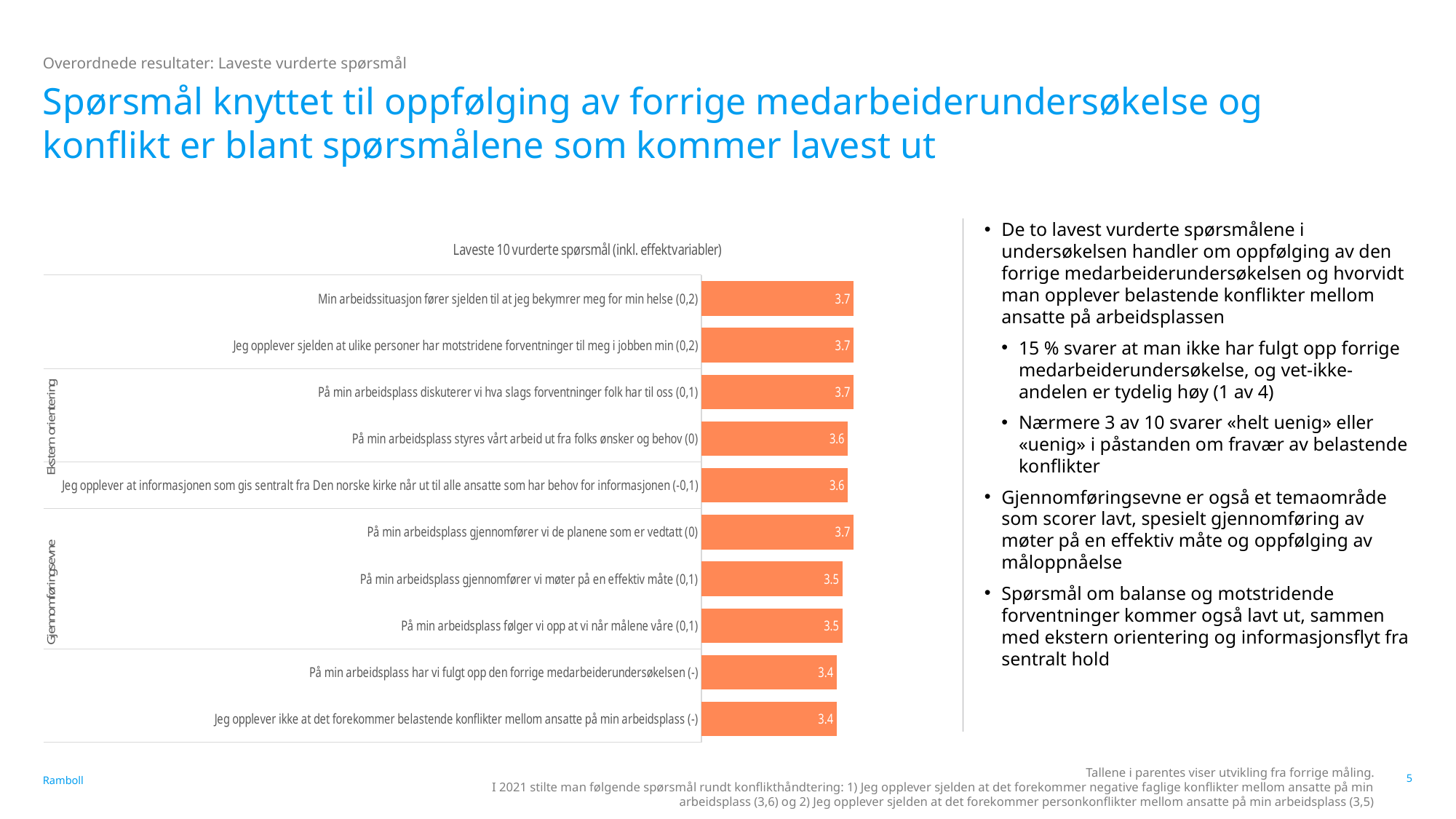
What is the title of the chart? Laveste 10 vurderte spørsmål (inkl. effektvariabler) What is the value for "På min arbeidsplass gjennomfører vi møter på en effektiv måte (0,1)"? 3.5 What is the value for "På min arbeidsplass styres vårt arbeid ut fra folks ønsker og behov (0)"? 3.6 Which has a higher value: "På min arbeidsplass diskuterer vi hva slags forventninger folk har til oss (0,1)" or "På min arbeidsplass har vi fulgt opp den forrige medarbeiderundersøkelsen (-)"? På min arbeidsplass diskuterer vi hva slags forventninger folk har til oss (0,1) How many bars (questions) are shown in the chart? 10 What is the value for "På min arbeidsplass har vi fulgt opp den forrige medarbeiderundersøkelsen (-)"? 3.4 What is the lowest value shown in the chart? 3.4 What are the two group labels shown along the left side of the chart? Ekstern orientering and Gjennomføringsevne What is the value for "Jeg opplever ikke at det forekommer belastende konflikter mellom ansatte på min arbeidsplass (-)"? 3.4 What is the difference between the value for "På min arbeidsplass gjennomfører vi de planene som er vedtatt (0)" and the value for "På min arbeidsplass følger vi opp at vi når målene våre (0,1)"? 0.2 What type of chart is shown on the slide? Bar chart What is the value for "Min arbeidssituasjon fører sjelden til at jeg bekymrer meg for min helse (0,2)"? 3.7